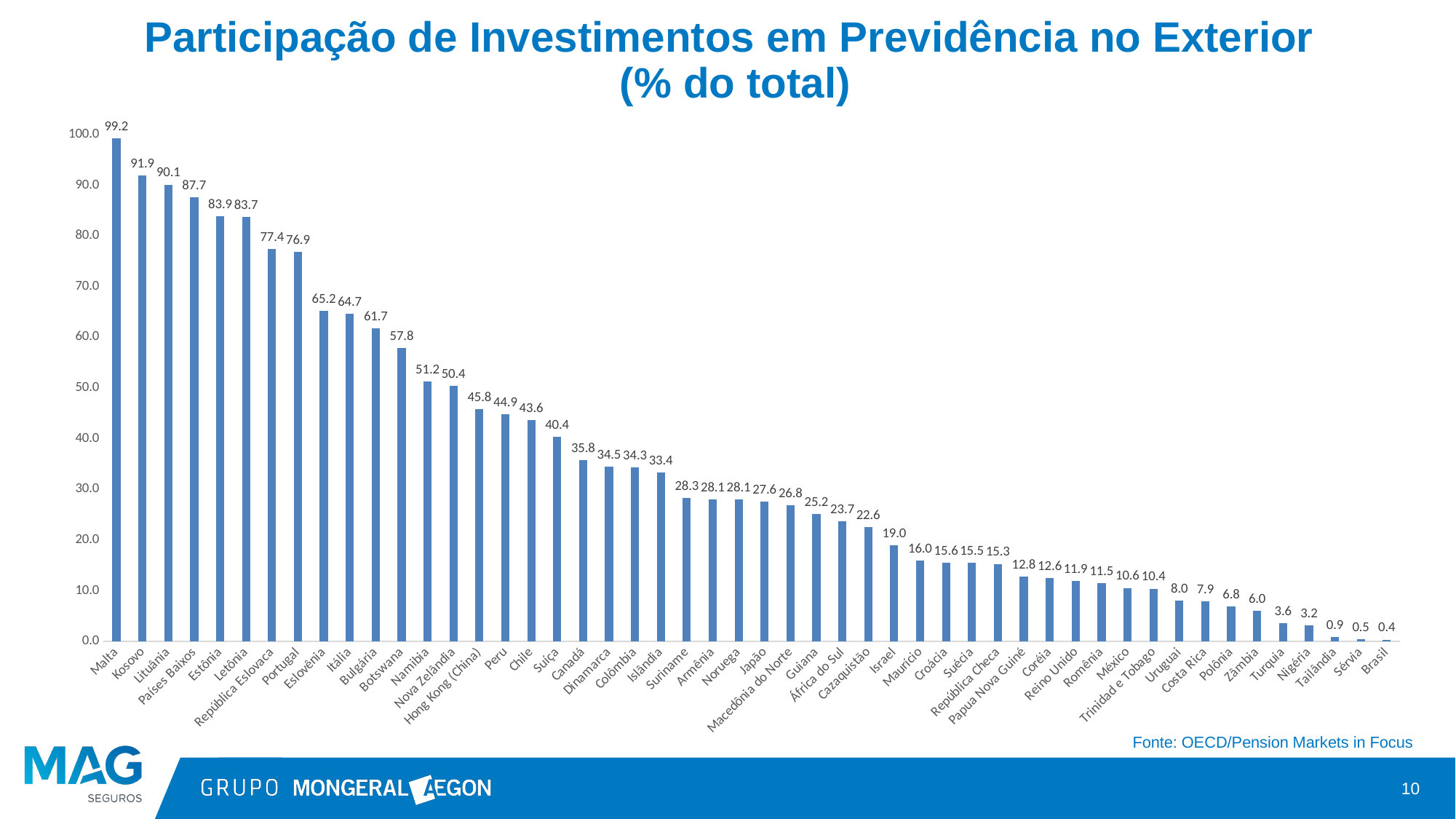
What kind of chart is shown on the slide? bar chart What is the value for Japão? 27.6 What is the difference between the values for Malta and Brasil? 98.8 Which country has the highest value? Malta How many countries are shown in the chart? 50 Is the value for Israel greater or less than 20.0? less What is the difference between the values for Portugal and Canadá? 41.1 Do the values rise or fall from left to right along the x axis? fall What is the value for Chile? 43.6 What is the value for Brasil? 0.4 Which country has the lowest value? Brasil Which has a larger value, Peru or Suíça? Peru